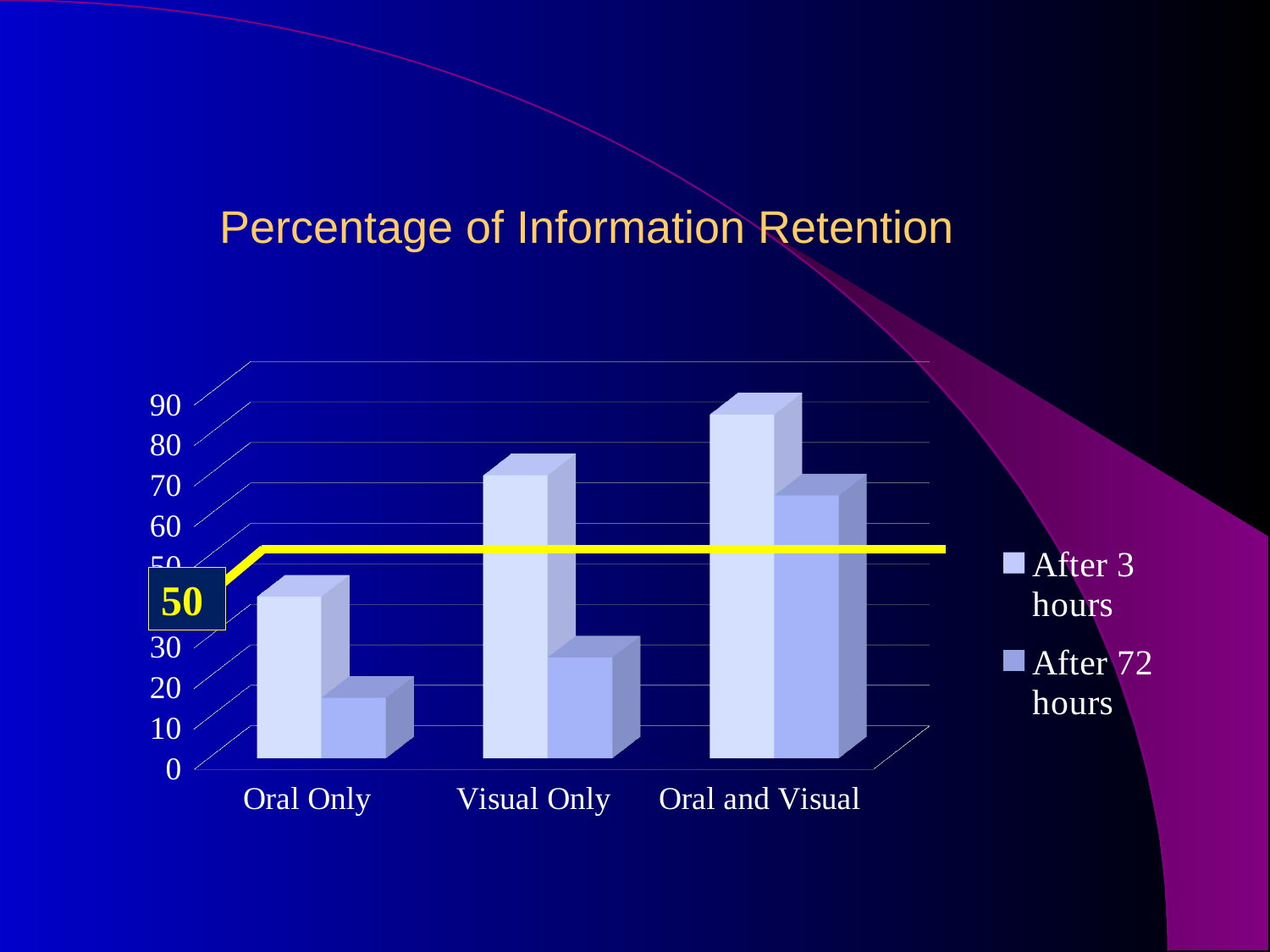
What is the title of the chart? Percentage of Information Retention How many series does the legend list? 2 Do the After 72 hours values rise or fall from Oral Only to Oral and Visual? rise Is the After 72 hours value for Visual Only greater or less than 50? less Is the After 72 hours value for Oral Only greater or less than 50? less How many categories are shown on the x axis? 3 Which category has the lowest value for After 72 hours? Oral Only Which category has the highest value for After 3 hours? Oral and Visual Is the After 72 hours value for Oral and Visual greater or less than 50? greater What kind of chart is shown on the slide? bar chart For Visual Only, which is larger: the After 3 hours value or the After 72 hours value? After 3 hours